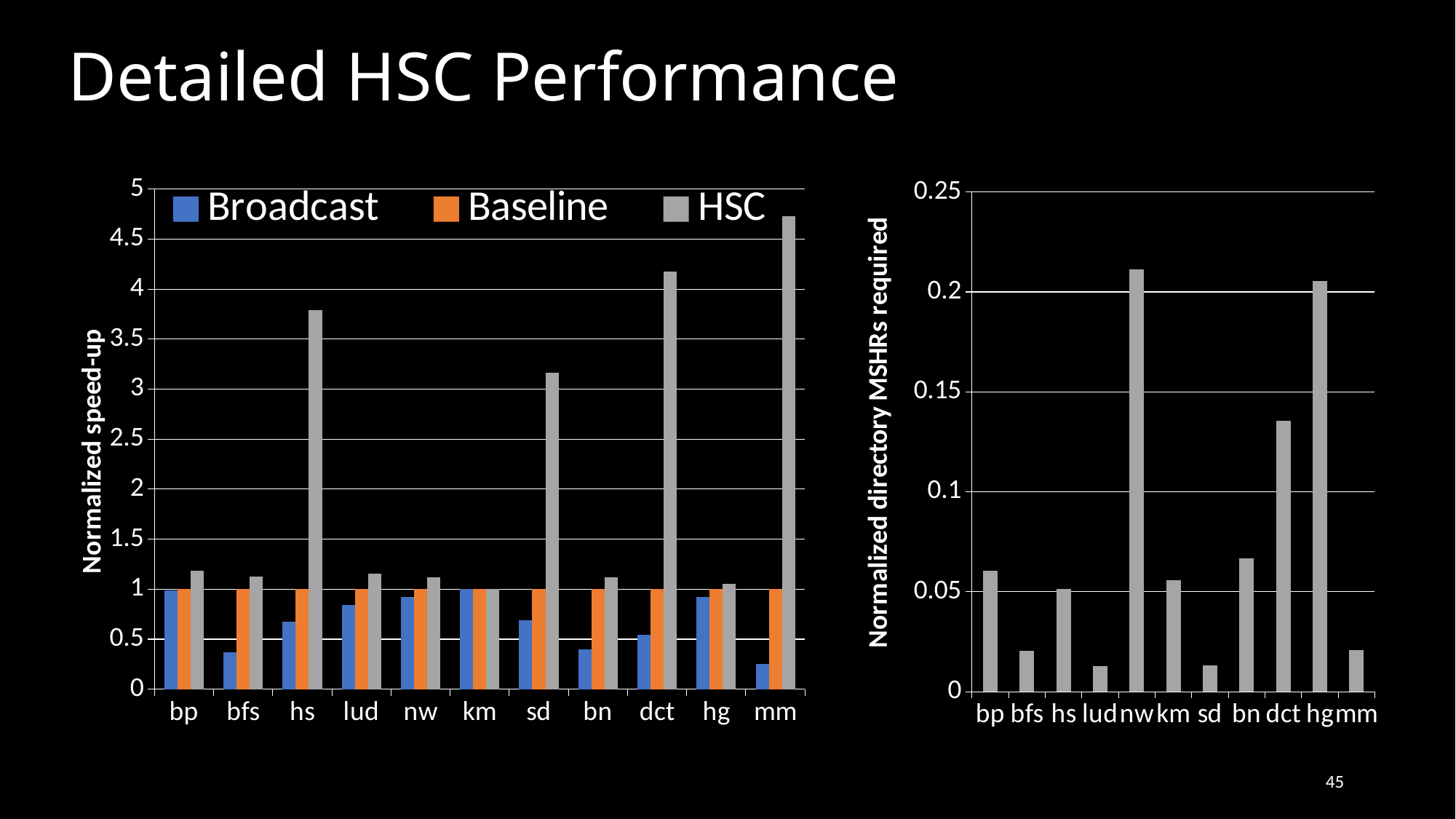
In the left chart (Normalized speed-up), which is larger: the HSC value for hs or the HSC value for sd? hs In the right chart (Normalized directory MSHRs required), is the value for dct greater or less than 0.15? less What kind of chart is the left chart (Normalized speed-up)? bar chart In the right chart (Normalized directory MSHRs required), which is larger: the value for nw or the value for dct? nw What are the three legend entries of the left chart (Normalized speed-up)? Broadcast, Baseline, HSC In the left chart (Normalized speed-up), is the HSC value for hs greater or less than 3.5? greater How many categories are shown on the x axis of the left chart (Normalized speed-up)? 11 In the left chart (Normalized speed-up), is the Broadcast value for bfs greater or less than 0.5? less How many series does the legend of the left chart (Normalized speed-up) list? 3 In the left chart (Normalized speed-up), which category has the highest HSC value? mm In the left chart (Normalized speed-up), which category has the lowest Broadcast value? mm In the left chart (Normalized speed-up), what is the Baseline value for bp? 1